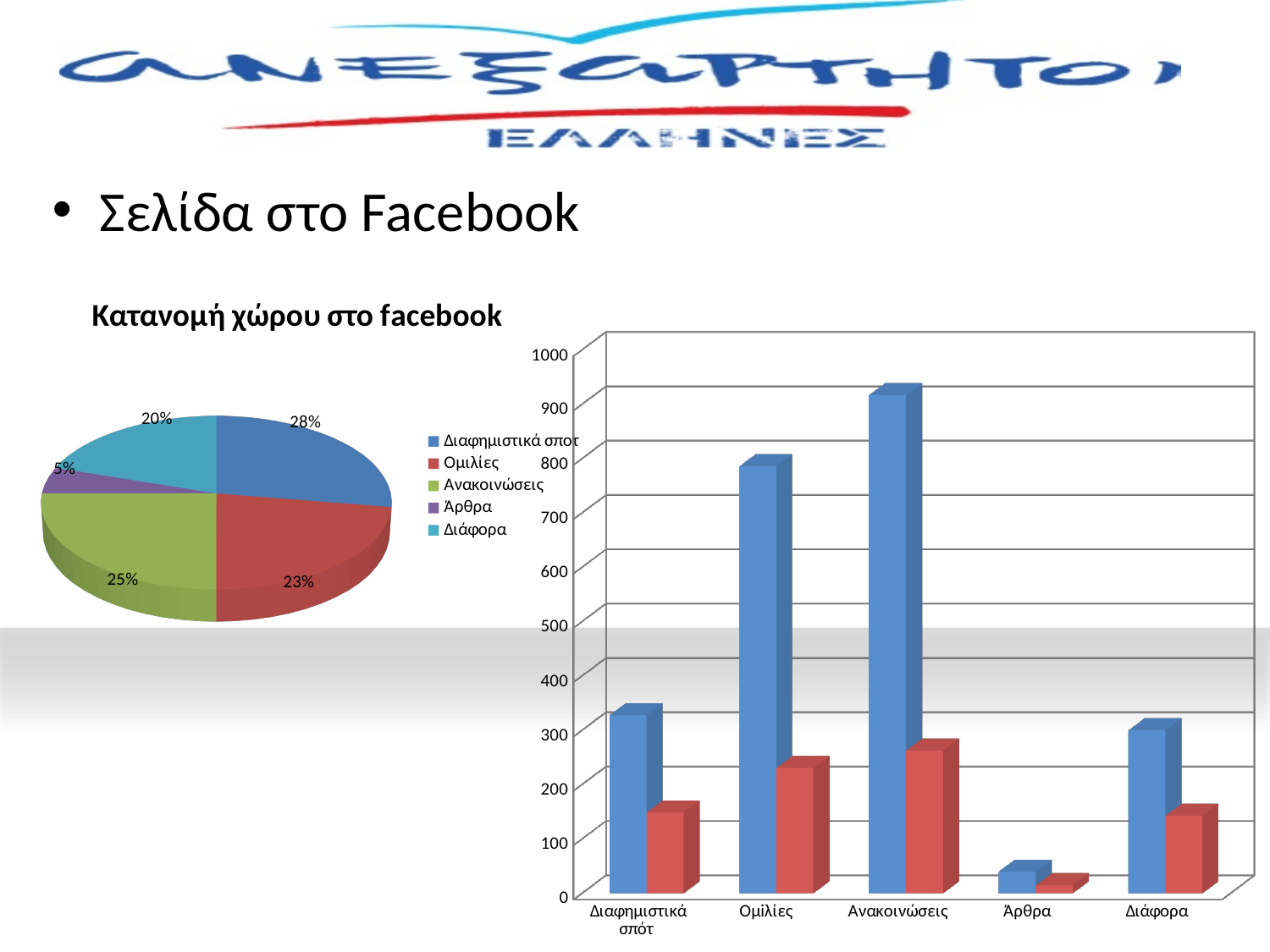
In the pie chart titled 'Κατανομή χώρου στο facebook', what is the difference in percentage points between Ανακοινώσεις and Ομιλίες? 2 In the bar chart on the right of the slide, is the blue bar for Ομιλίες greater or less than 700? greater In the pie chart titled 'Κατανομή χώρου στο facebook', which category has the smallest share? Άρθρα What kind of chart is the chart on the right of the slide? Bar chart How many categories are shown on the x axis of the bar chart on the right of the slide? 5 In the bar chart on the right of the slide, which category has the tallest blue bar? Ανακοινώσεις In the pie chart titled 'Κατανομή χώρου στο facebook', what percentage is shown for Διαφημιστικά σποτ? 28% What kind of chart is the chart on the left of the slide? Pie chart In the pie chart titled 'Κατανομή χώρου στο facebook', what percentage is shown for Άρθρα? 5% In the pie chart titled 'Κατανομή χώρου στο facebook', which is larger: the share for Διάφορα or the share for Ομιλίες? Ομιλίες How many entries does the legend of the pie chart titled 'Κατανομή χώρου στο facebook' list? 5 In the pie chart titled 'Κατανομή χώρου στο facebook', which category has the largest share? Διαφημιστικά σποτ